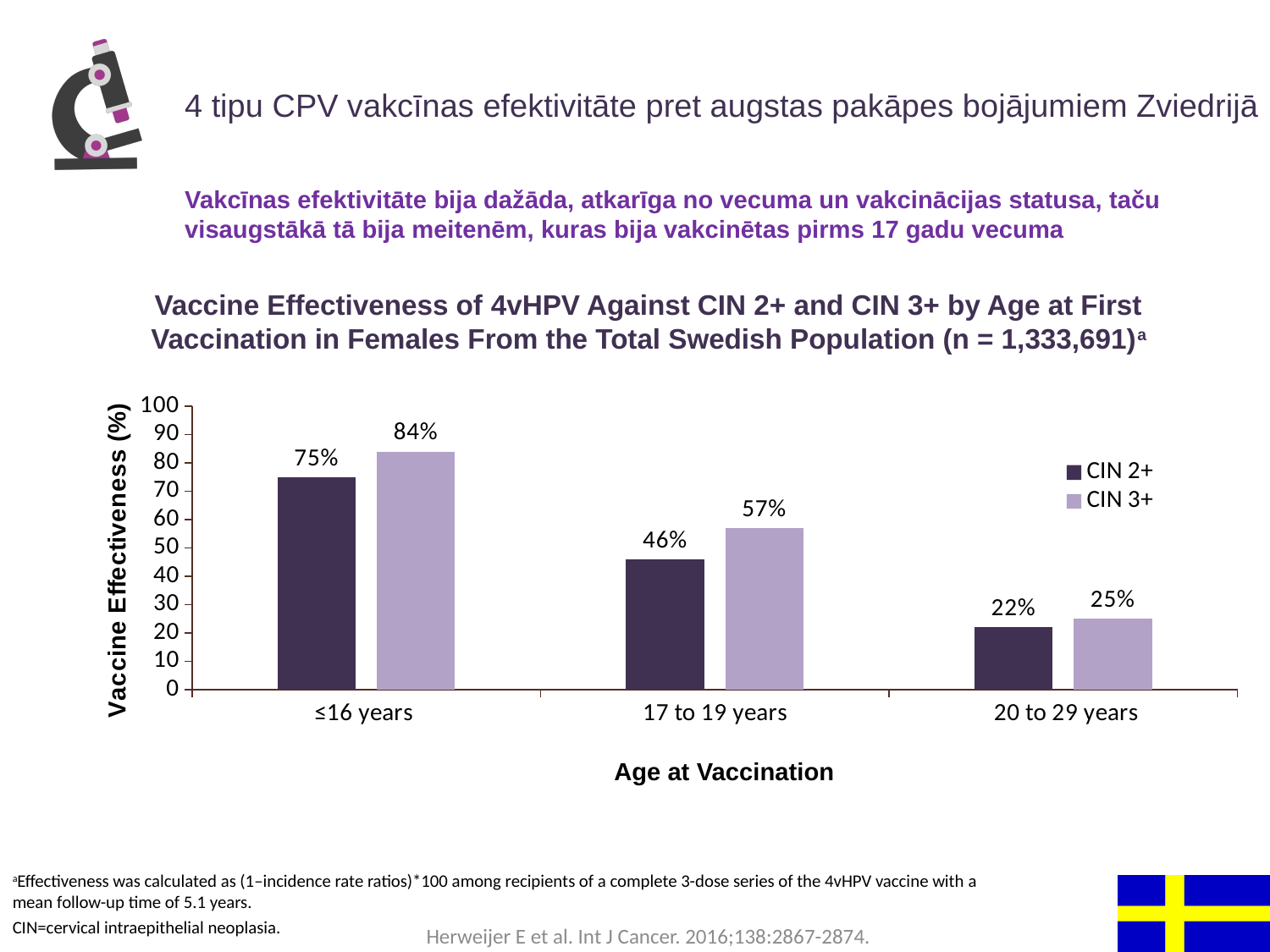
How many series does the legend list? 2 Which age group has the highest vaccine effectiveness for CIN 3+? ≤16 years What is the difference in CIN 2+ effectiveness between the ≤16 years group and the 17 to 19 years group? 29% What is the vaccine effectiveness for CIN 2+ in the 20 to 29 years group? 22% Do the CIN 2+ values rise or fall as age at vaccination increases along the x axis? Fall Which is larger: CIN 3+ effectiveness in the 17 to 19 years group or CIN 2+ effectiveness in the ≤16 years group? CIN 2+ effectiveness in the ≤16 years group How many age groups are shown on the x axis? 3 What kind of chart is shown on the slide? Bar chart What is the vaccine effectiveness for CIN 3+ in the 17 to 19 years group? 57% What is the vaccine effectiveness for CIN 2+ in the ≤16 years group? 75% Which age group has the lowest vaccine effectiveness for CIN 2+? 20 to 29 years What is the difference between CIN 3+ and CIN 2+ effectiveness in the ≤16 years group? 9%